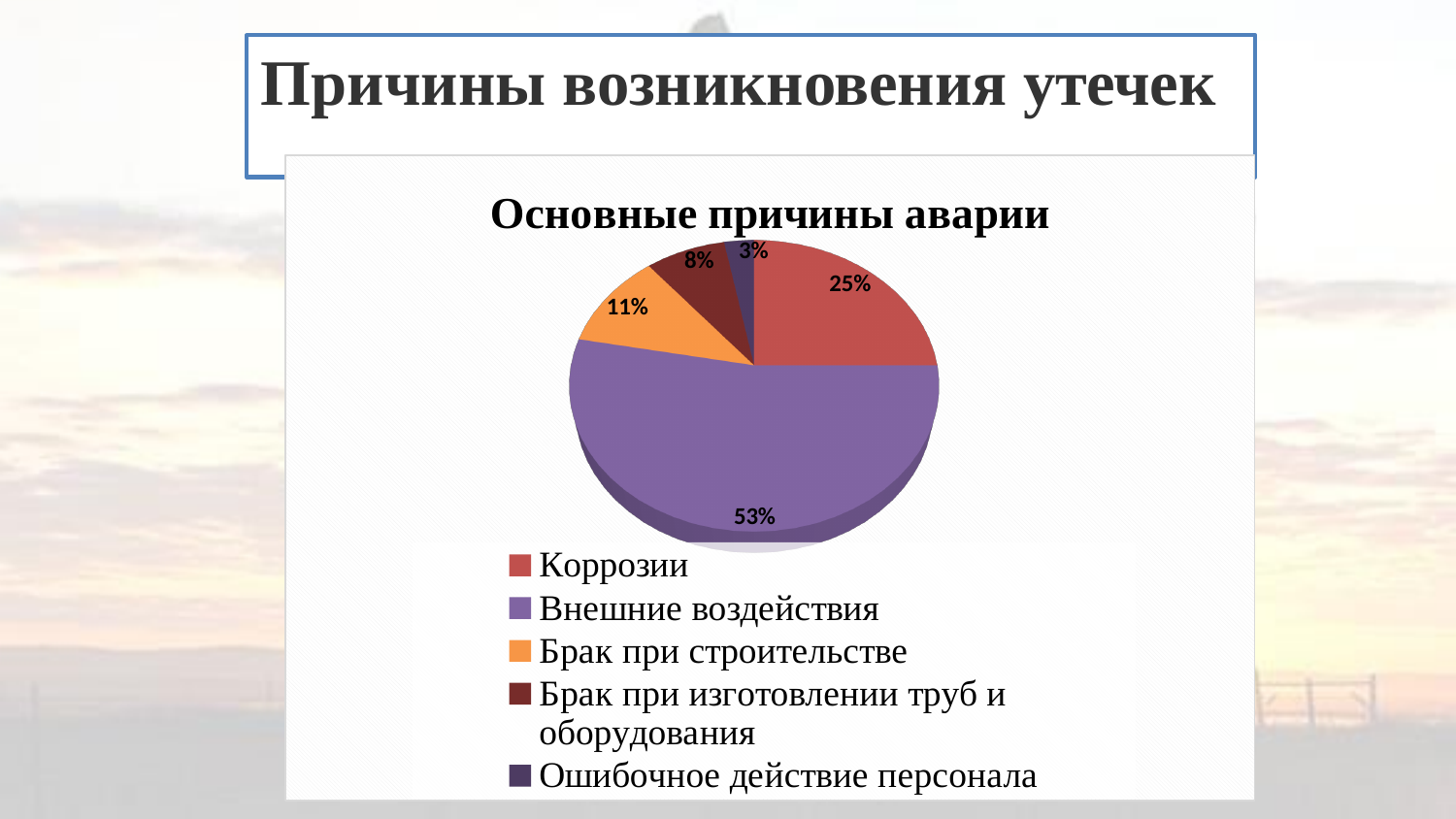
What is the value for Коррозии? 25% What is the title of the chart? Основные причины аварии What is the value for Брак при строительстве? 11% What is the difference between the values for Внешние воздействия and Коррозии? 28% Which category has the largest slice of the pie? Внешние воздействия Which category has the smallest slice of the pie? Ошибочное действие персонала Which is larger, the value for Брак при строительстве or the value for Брак при изготовлении труб и оборудования? Брак при строительстве What kind of chart is shown on the slide? pie chart What share of the pie does Внешние воздействия take? 53% What is the value for Ошибочное действие персонала? 3% What is the value for Брак при изготовлении труб и оборудования? 8% How many categories are shown in the pie chart? 5